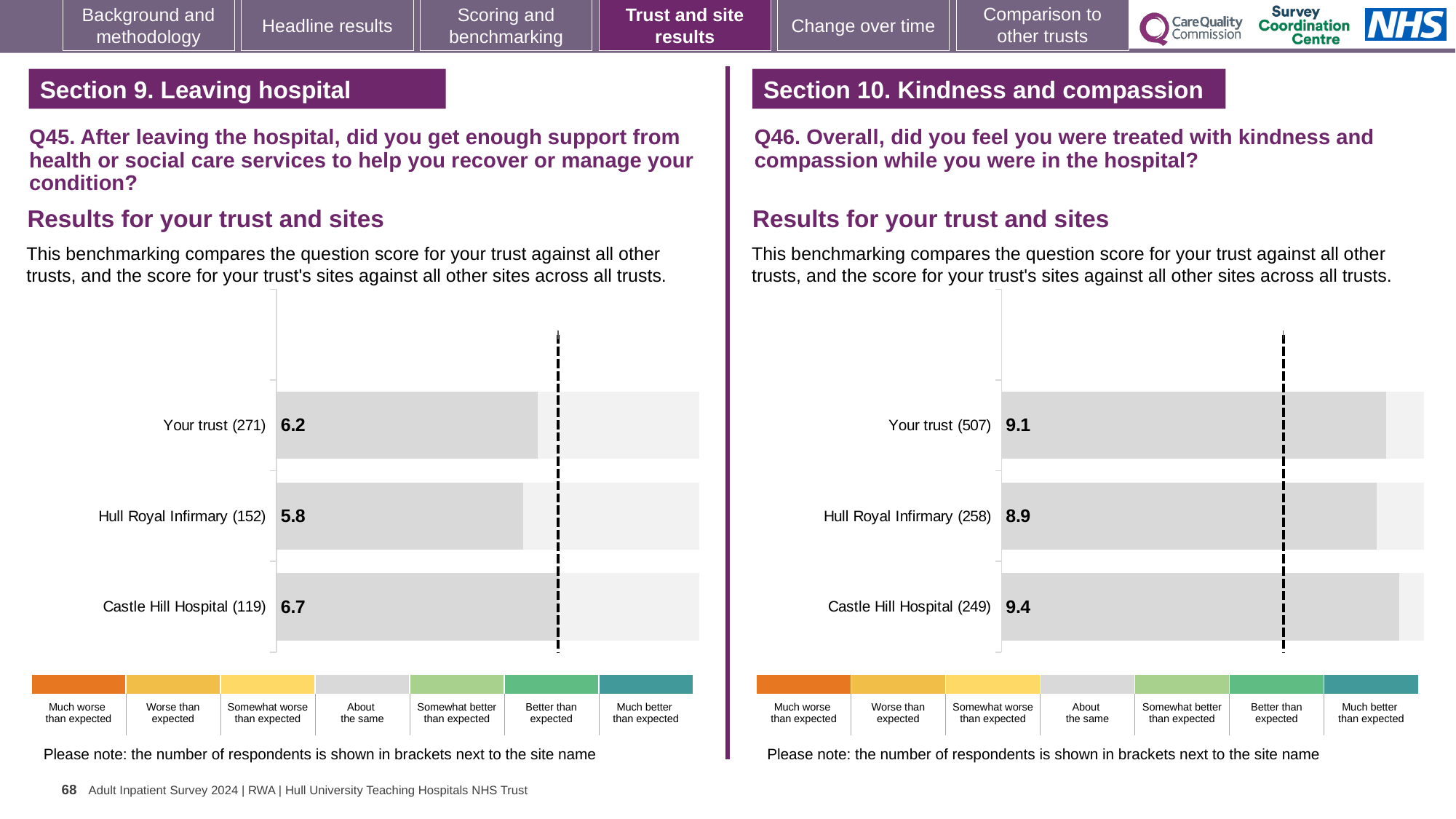
In the Q46 chart on the right, which site or trust has the lowest score? Hull Royal Infirmary What kind of chart is used for the Q46 results on the right? Bar chart In the Q46 chart on the right, what is the score for Your trust? 9.1 In the Q46 chart on the right, what is the difference between the scores for Your trust and Hull Royal Infirmary? 0.2 In the Q45 chart on the left, what is the score for Hull Royal Infirmary? 5.8 How many bars are plotted in the Q45 chart on the left? 3 In the Q46 chart on the right, what is the score for Castle Hill Hospital? 9.4 In the Q45 chart on the left, what is the score for Your trust? 6.2 In the Q45 chart on the left, which site or trust has the highest score? Castle Hill Hospital In the Q45 chart on the left, which site or trust has the lowest score? Hull Royal Infirmary In the Q46 chart on the right, is the score for Castle Hill Hospital or Hull Royal Infirmary larger? Castle Hill Hospital In the Q45 chart on the left, what is the difference between the scores for Castle Hill Hospital and Hull Royal Infirmary? 0.9